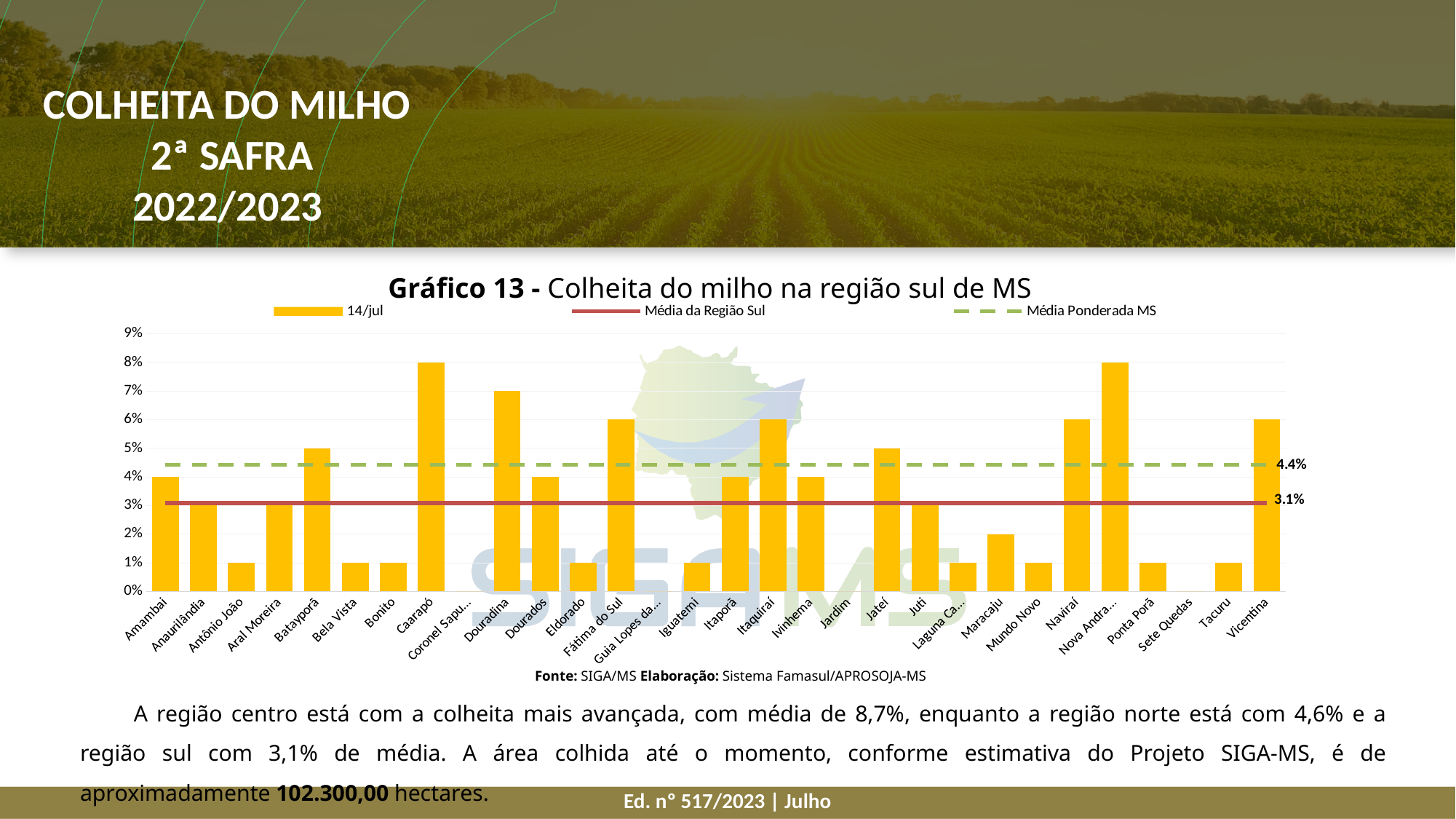
How many series does the legend of Gráfico 13 list? 3 What is the 14/jul value for Douradina in Gráfico 13? 7% What is the 14/jul value for Maracaju in Gráfico 13? 2% Is the bar for Fátima do Sul in Gráfico 13 greater or less than 5%? greater What is the date shown in the legend for the bars in Gráfico 13? 14/jul What kind of chart is Gráfico 13? Bar chart How many municipalities are shown on the x axis of Gráfico 13? 30 What is the 14/jul value for Caarapó in Gráfico 13? 8% What is the difference between the Média Ponderada MS and the Média da Região Sul in Gráfico 13? 1.3% Which is larger in Gráfico 13, the bar for Batayporã or the bar for Dourados? Batayporã What is the value of the Média Ponderada MS line in Gráfico 13? 4.4% What is the value of the Média da Região Sul line in Gráfico 13? 3.1%